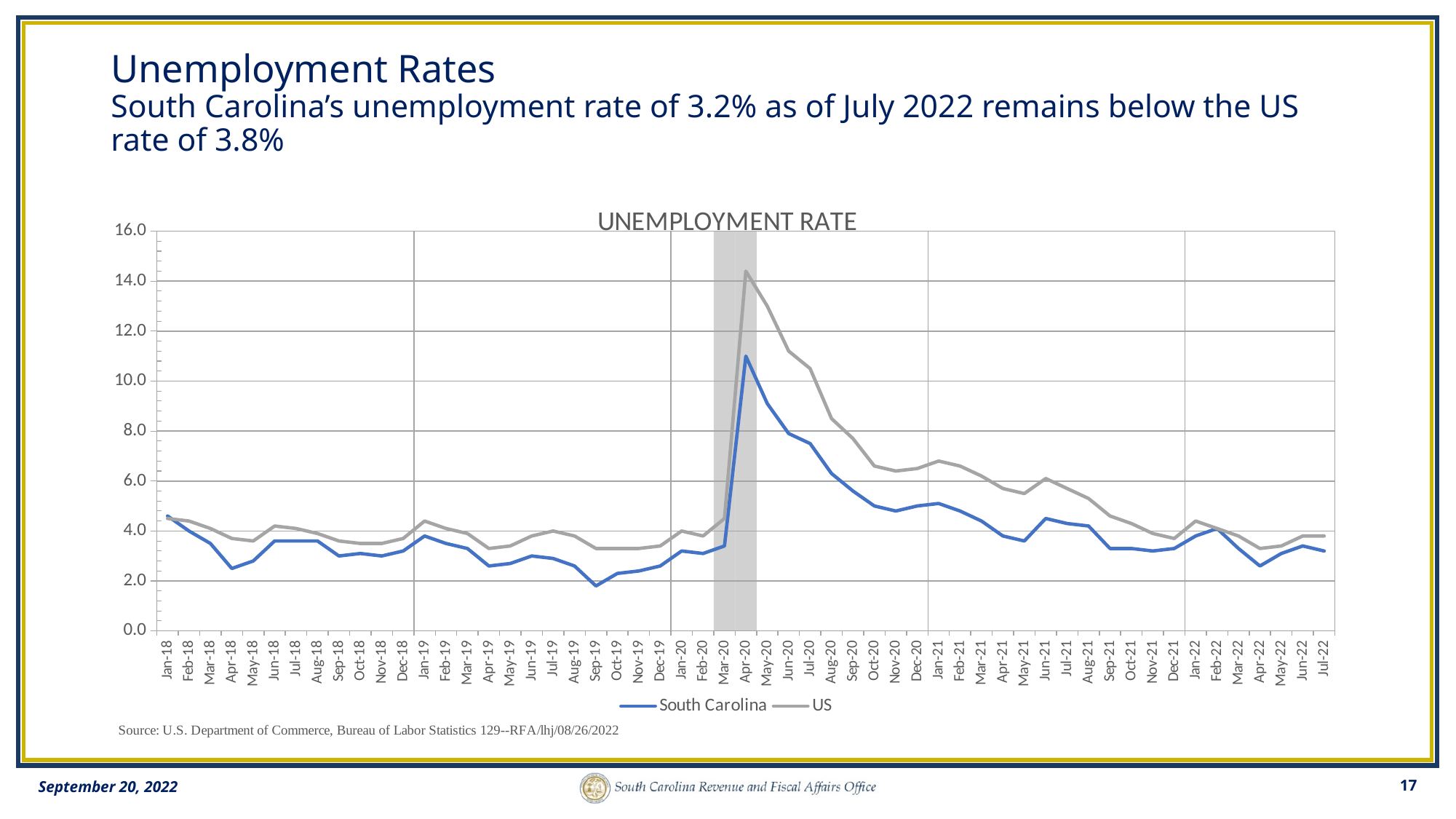
Is the US unemployment rate in Apr-20 greater or less than 12.0? greater According to the slide, what is the US unemployment rate as of July 2022? 3.8% In which month does the US unemployment rate reach its highest point? Apr-20 What kind of chart is shown on the slide? line chart In which month does the South Carolina unemployment rate reach its highest point? Apr-20 How many series does the chart legend list? 2 Is the South Carolina unemployment rate in Apr-20 greater or less than 8.0? greater Which colour is used for the South Carolina line? blue In which month does the South Carolina unemployment rate reach its lowest point? Sep-19 By how much does the US unemployment rate exceed South Carolina's rate as of July 2022? 0.6% Which series is higher in Apr-20, South Carolina or US? US According to the slide, what is South Carolina's unemployment rate as of July 2022? 3.2%